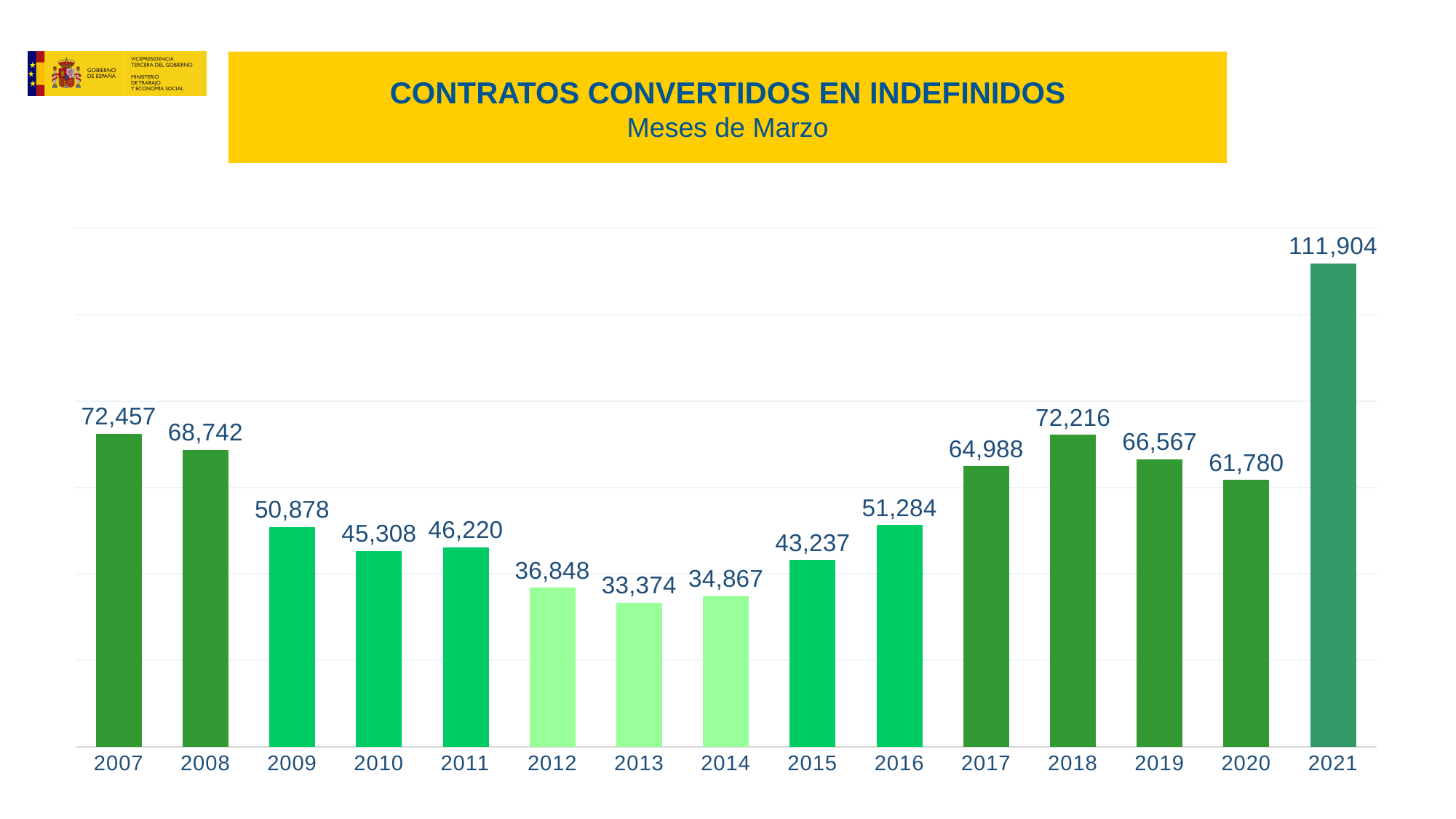
What is the difference between the values for 2021 and 2020? 50,124 What is the value for 2013? 33,374 What type of chart is shown on the slide? bar chart Which year has the lowest value? 2013 Do the values rise or fall from 2013 to 2018? rise What is the value for 2009? 50,878 Which year has the larger value, 2017 or 2019? 2019 What is the value for 2021? 111,904 Which year has the highest value? 2021 What is the value for 2016? 51,284 How many years are shown on the x axis of the chart? 15 What is the title of the chart? CONTRATOS CONVERTIDOS EN INDEFINIDOS